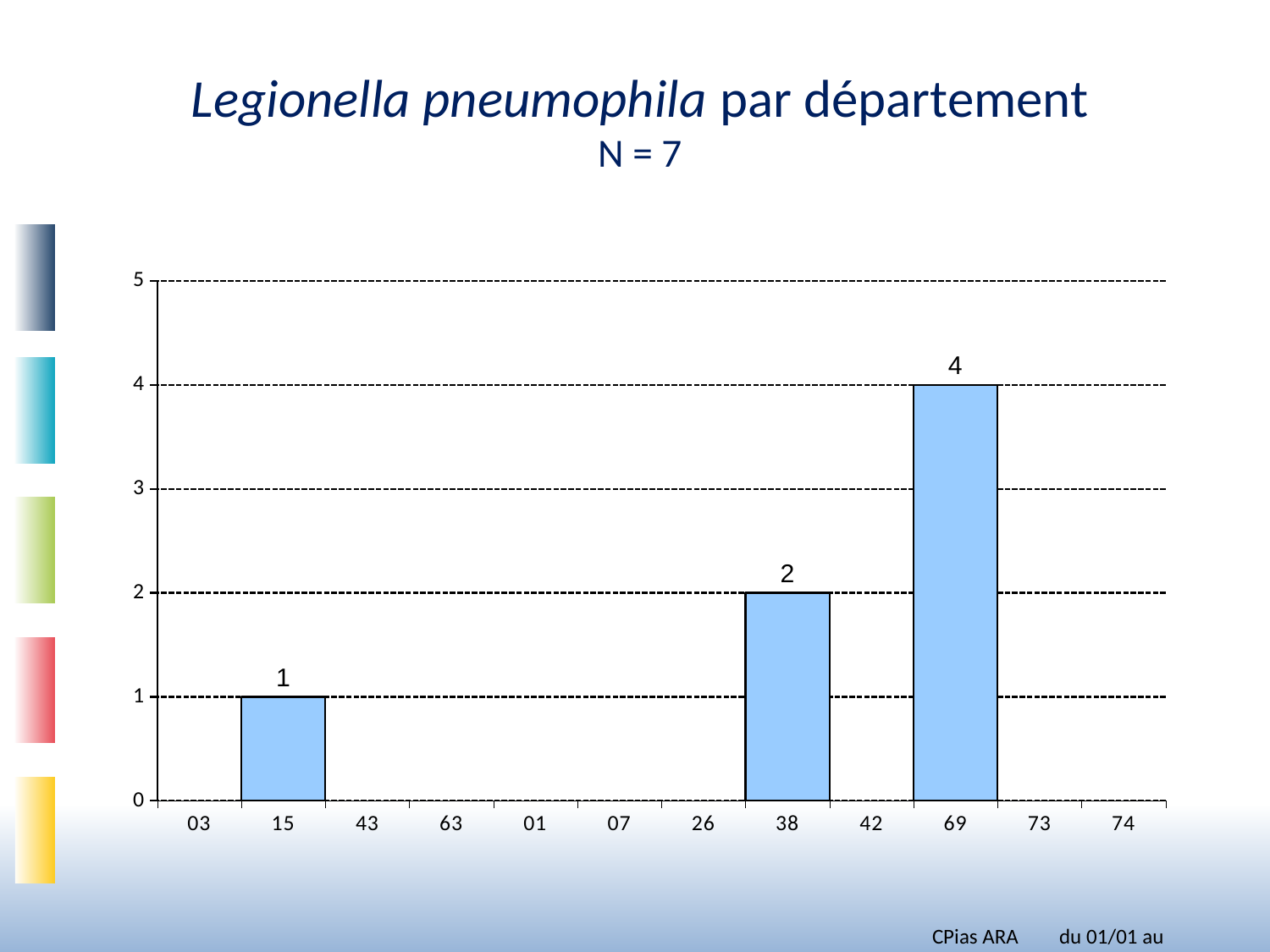
What kind of chart is shown on the slide? bar chart What is the value for département 38? 2 How many départements are listed on the x axis? 12 How many départements have a bar with a value greater than zero? 3 What is the total N stated in the chart title? 7 What is the difference between the values for départements 69 and 38? 2 What is the difference between the values for départements 38 and 15? 1 What is the value for département 69? 4 Is the value for département 69 greater or less than 3? greater Which is larger, the value for département 69 or for département 15? 69 Which département has the highest value? 69 What is the value for département 15? 1